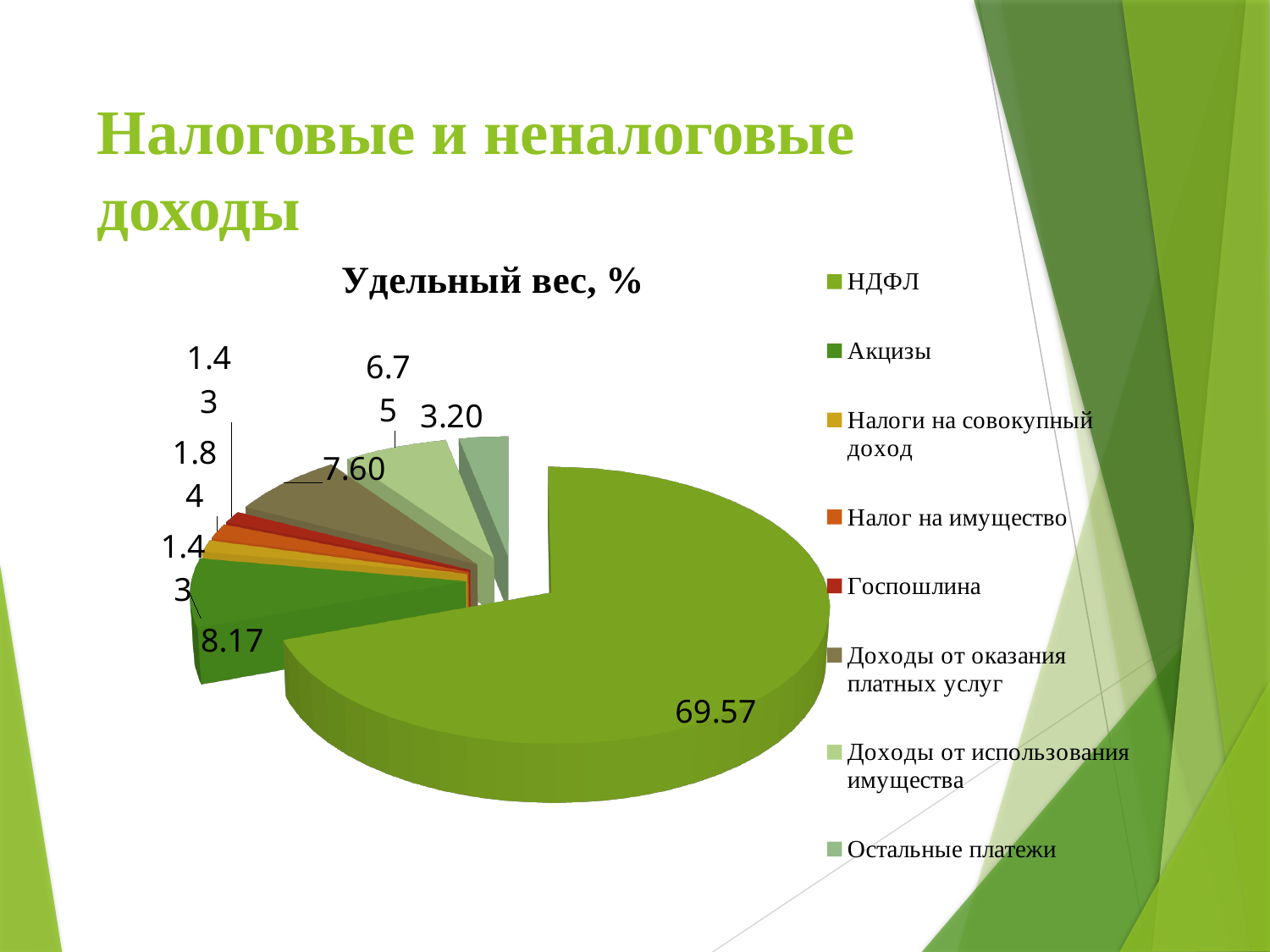
What type of chart is shown on the slide? Pie chart Which is larger: Акцизы or Доходы от оказания платных услуг? Акцизы What is the value for НДФЛ in the pie chart? 69.57 What is the difference between the values for НДФЛ and Акцизы? 61.40 What is the value for Доходы от оказания платных услуг in the pie chart? 7.60 What is the value for Остальные платежи in the pie chart? 3.20 What is the difference between the values for Акцизы and Доходы от оказания платных услуг? 0.57 Which category has the largest slice of the pie chart? НДФЛ Which is larger: Остальные платежи or Доходы от оказания платных услуг? Доходы от оказания платных услуг What is the title of the pie chart? Удельный вес, % How many categories does the legend of the pie chart list? 8 What is the value for Акцизы in the pie chart? 8.17